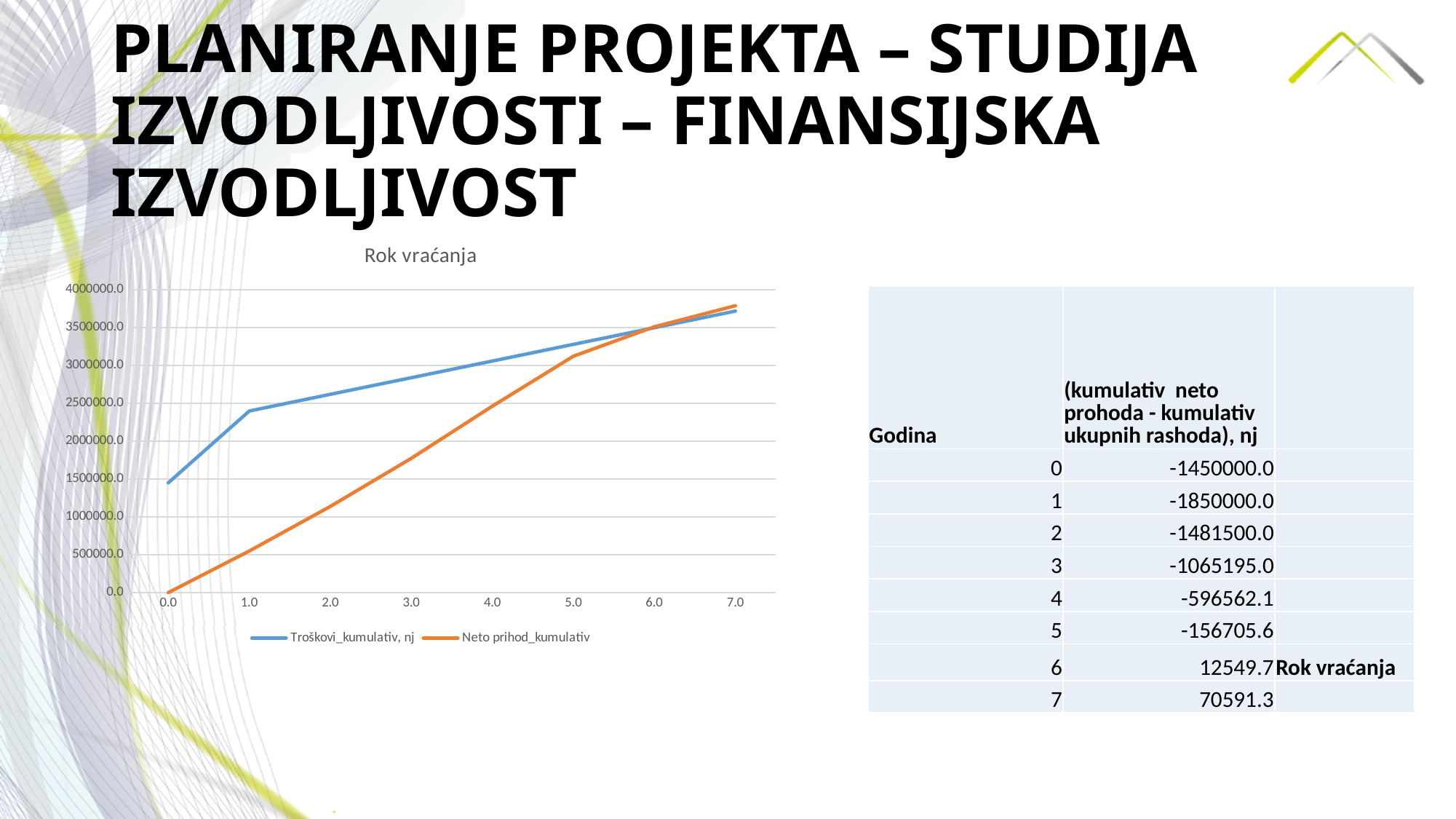
Is the value of Troškovi_kumulativ, nj at x = 1.0 greater or less than 2000000.0? greater Is the value of Neto prihod_kumulativ at x = 5.0 greater or less than 2500000.0? greater What kind of chart is shown on the slide? line chart Is the value of Troškovi_kumulativ, nj at x = 0.0 greater or less than 1000000.0? greater At x = 3.0, which series has the larger value, Troškovi_kumulativ, nj or Neto prihod_kumulativ? Troškovi_kumulativ, nj Does the Neto prihod_kumulativ series rise or fall as x increases from 0.0 to 7.0? rise How many x-axis points (years) are plotted for each series in the chart? 8 What is the title of the chart? Rok vraćanja How many series does the chart's legend list? 2 What is the value of Neto prihod_kumulativ at x = 0.0? 0.0 Which series is drawn in orange in the chart? Neto prihod_kumulativ